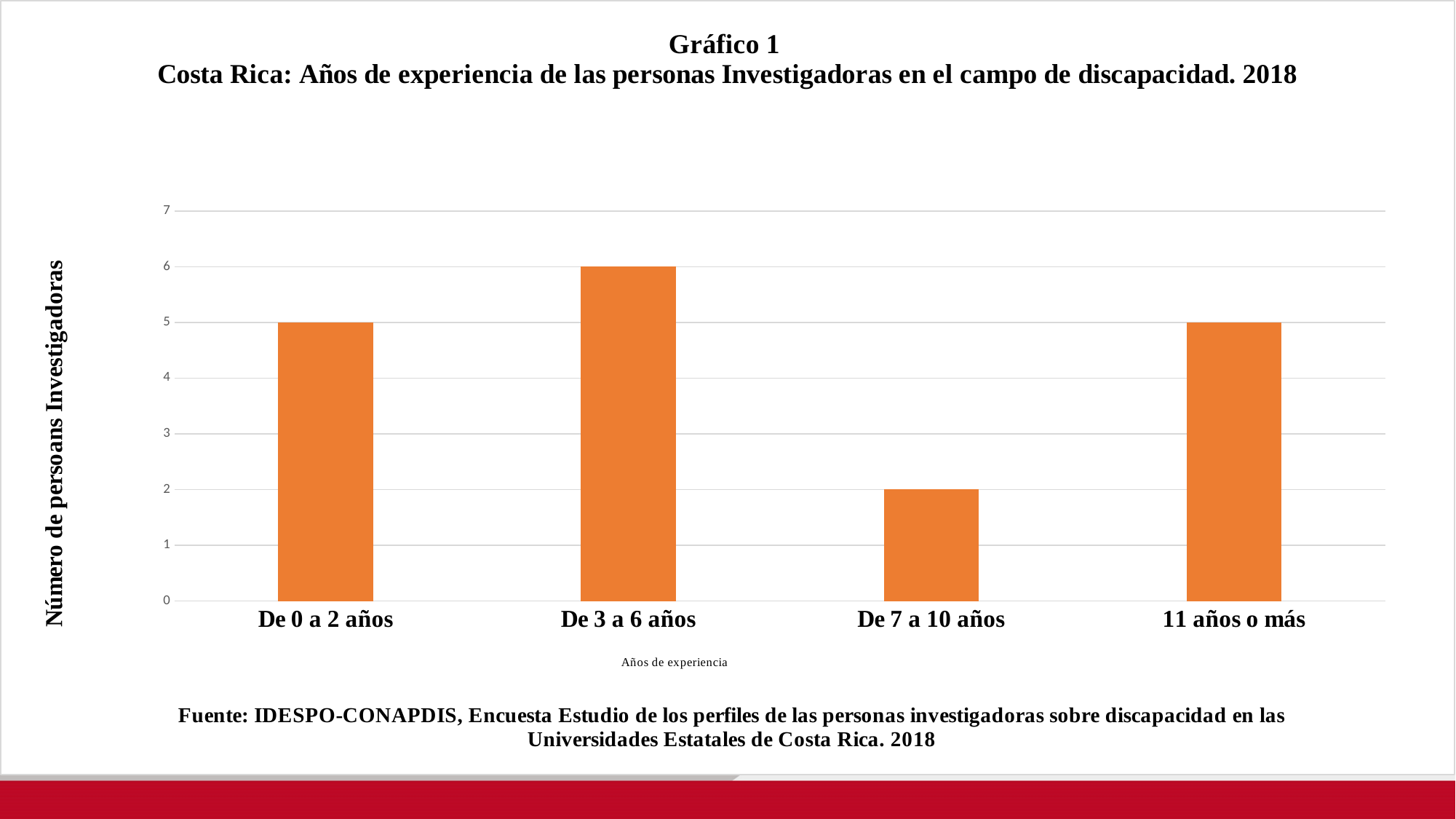
What is the number of researchers with '11 años o más' of experience? 5 Which category of years of experience has the highest number of researchers? De 3 a 6 años What is the number of researchers with 'De 0 a 2 años' of experience? 5 What is the label of the y axis? Número de persoans Investigadoras What is the number of researchers with 'De 3 a 6 años' of experience? 6 Which category of years of experience has the lowest number of researchers? De 7 a 10 años What is the number of researchers with 'De 7 a 10 años' of experience? 2 What type of chart is shown on the slide? Bar chart What is the label of the x axis? Años de experiencia Which has more researchers: 'De 0 a 2 años' or 'De 7 a 10 años'? De 0 a 2 años What is the difference between the number of researchers with 'De 3 a 6 años' and 'De 7 a 10 años' of experience? 4 How many categories of years of experience are shown on the x axis? 4